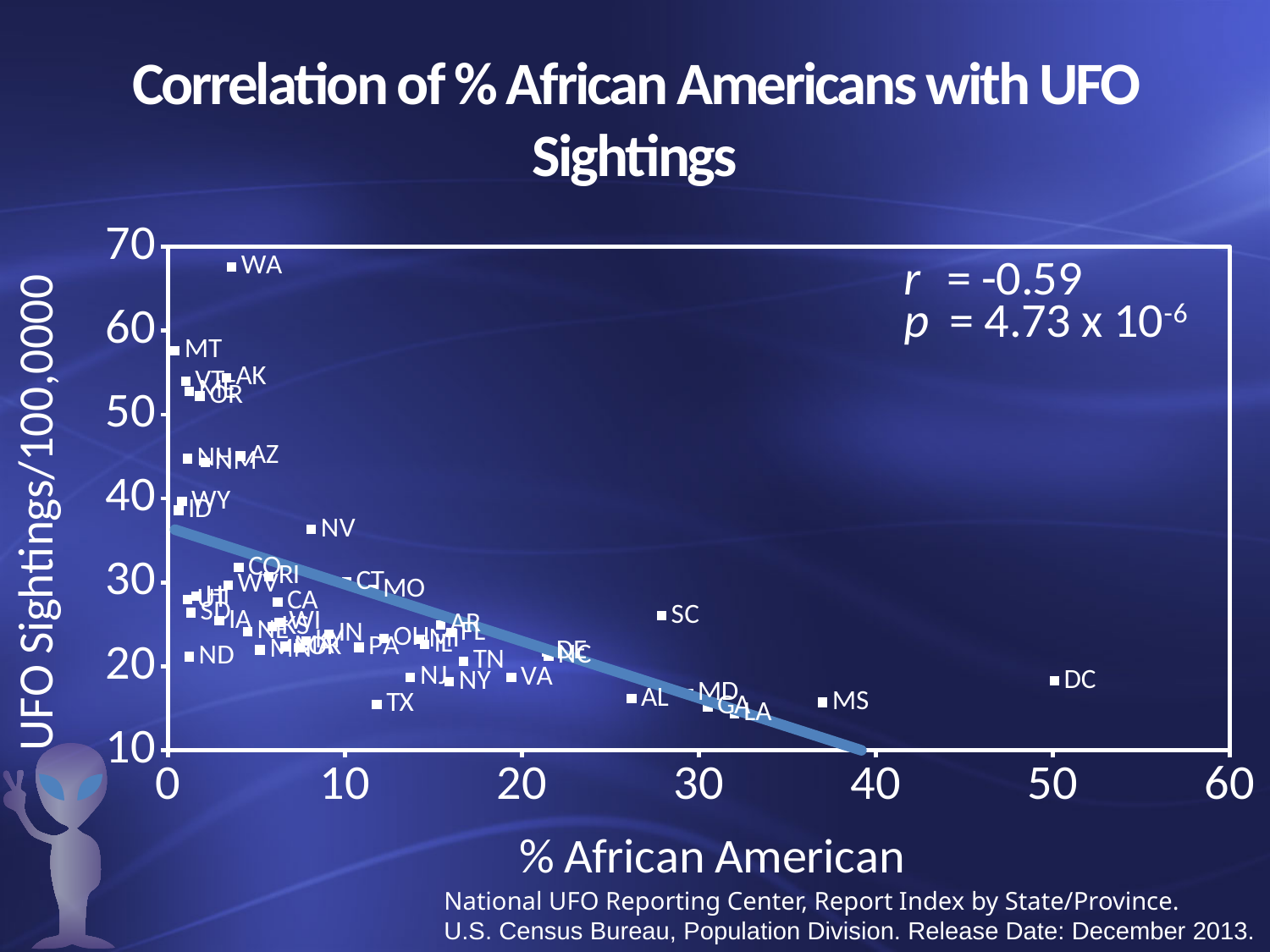
Which state has the highest UFO sightings per 100,000 on the chart? WA Is the UFO sightings value for MT greater or less than 50? greater Which has a higher % African American, DC or WA? DC What is the label of the x axis? % African American What kind of chart is shown on the slide? scatter plot Which has more UFO sightings per 100,000, SC or AL? SC Do UFO sightings tend to rise or fall as % African American increases along the x axis? fall What correlation coefficient r is shown on the chart? -0.59 Is the UFO sightings value for NV greater or less than 40? less Is the UFO sightings value for TX greater or less than 20? less